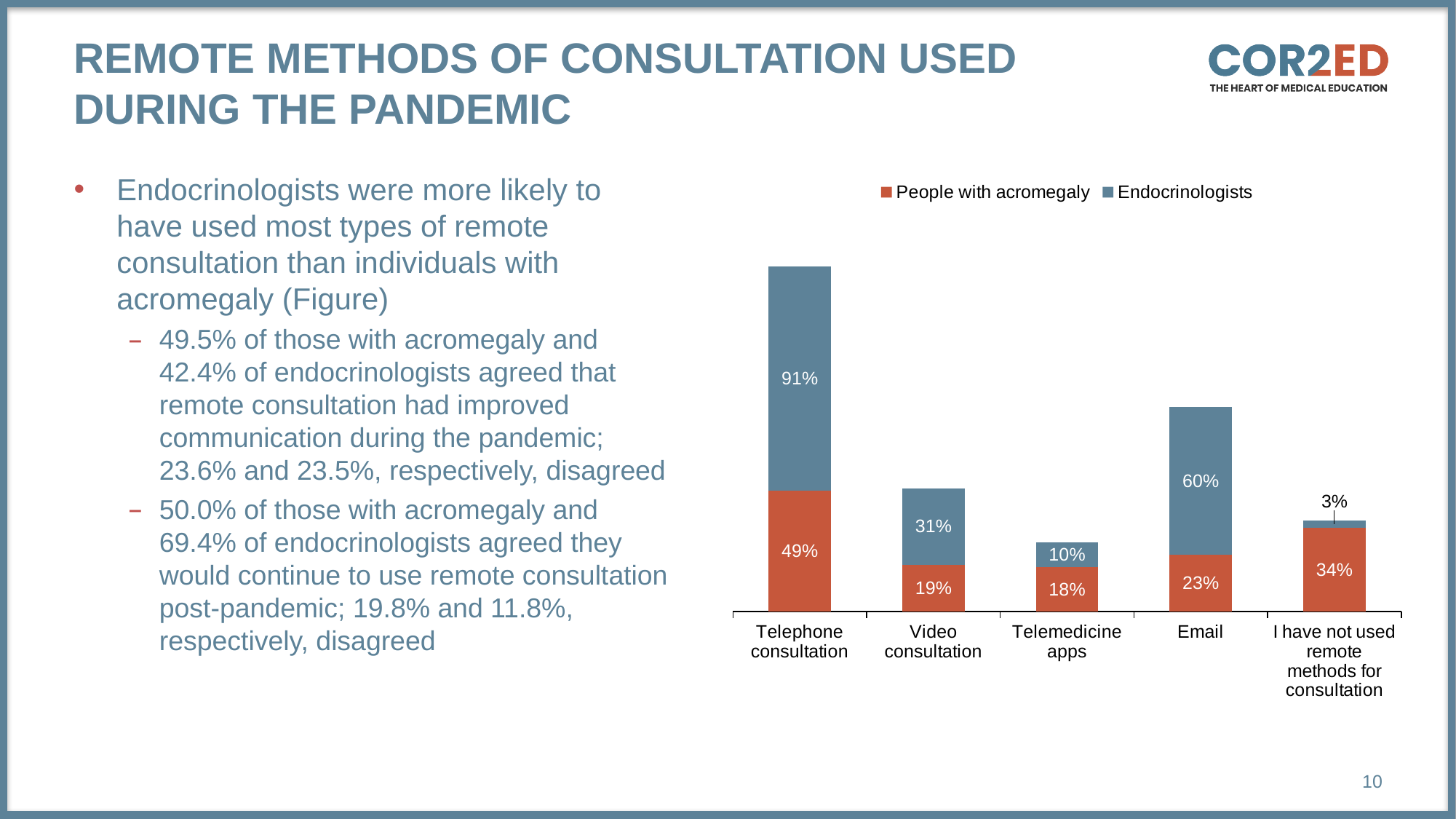
Which remote method has the highest value for endocrinologists? Telephone consultation What percentage of people with acromegaly had not used remote methods for consultation? 34% What is the difference between the endocrinologists and people with acromegaly values for email? 37% For video consultation, which group has the larger value: people with acromegaly or endocrinologists? Endocrinologists How many series does the chart legend list? 2 Which category has the lowest value for endocrinologists? I have not used remote methods for consultation What percentage of people with acromegaly used email? 23% What is the total of the stacked bar for telephone consultation? 140% What percentage of endocrinologists used telemedicine apps? 10% How many categories are shown on the x axis of the chart? 5 What kind of chart is shown on the slide? Stacked bar chart What percentage of endocrinologists used telephone consultation? 91%